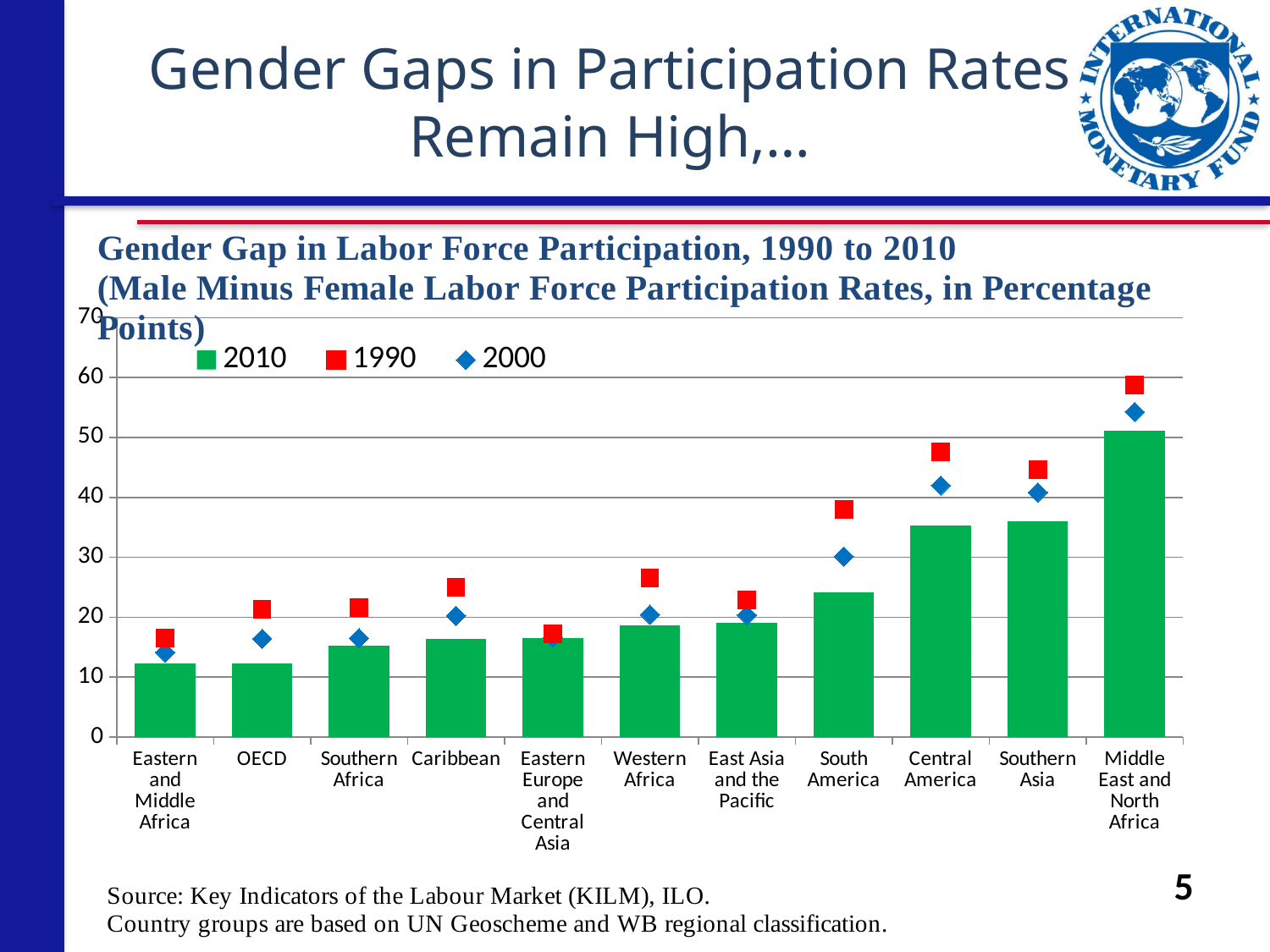
How many series does the chart's legend list? 3 Which is larger, the 2010 value for South America or the 2010 value for East Asia and the Pacific? South America Is the 2010 value for Central America greater or less than 40? less Which region has the highest 1990 value (red square)? Middle East and North Africa Which series is shown as green bars in the chart? 2010 Is the 2010 value for South America greater or less than 20? greater What kind of chart is shown on the slide? bar chart (with point markers) Is the 2010 value for Middle East and North Africa greater or less than 40? greater For the Caribbean, which is larger, the 1990 value or the 2000 value? 1990 How many regions are shown on the x axis of the chart? 11 Which region has the highest 2010 gender gap bar? Middle East and North Africa